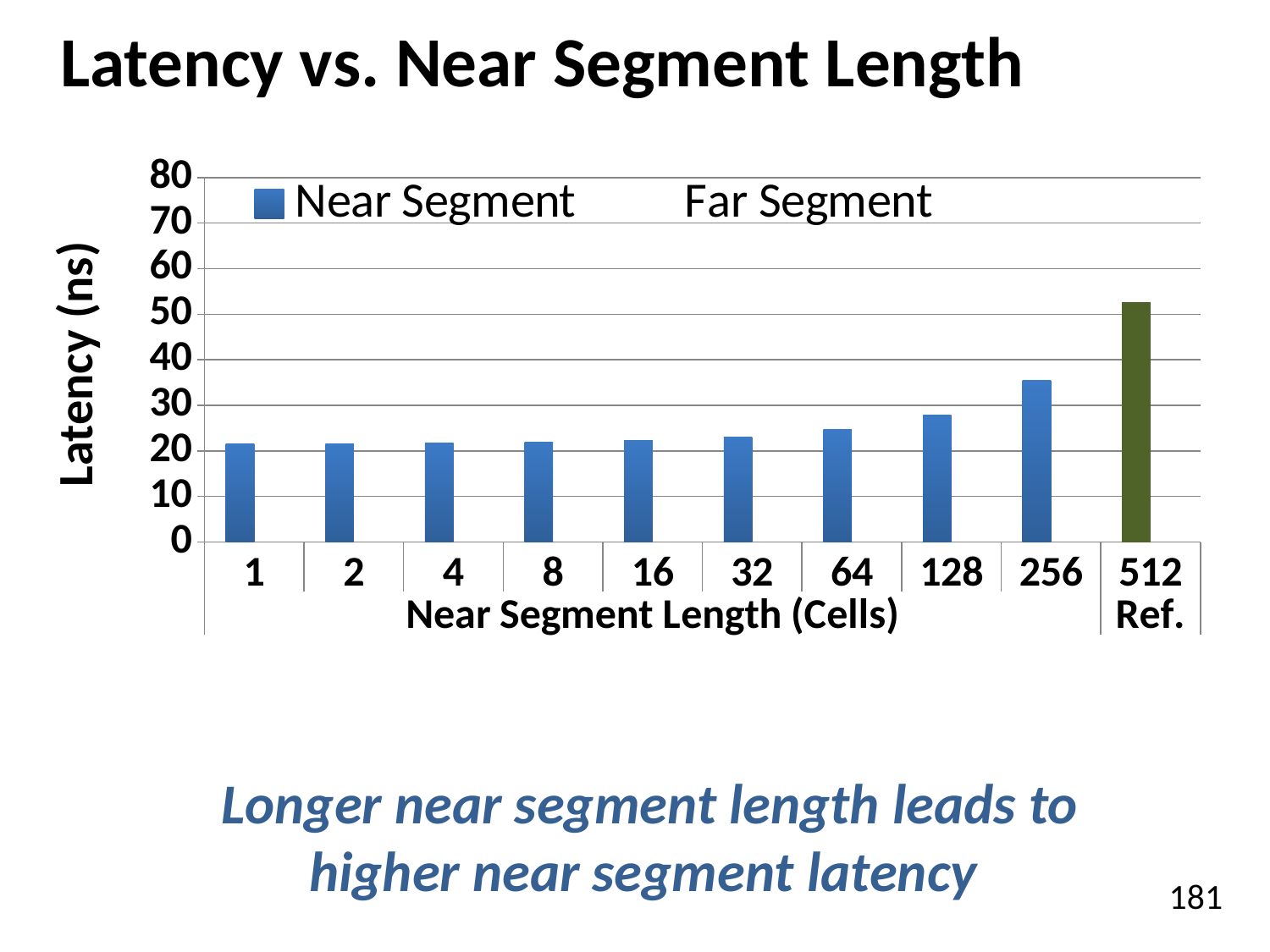
Is the latency for a near segment length of 1 greater or less than 20? greater What is the title of the chart on the slide? Latency vs. Near Segment Length What is the title of the y axis? Latency (ns) Do the near segment latency values rise or fall as near segment length increases along the x axis? rise How many bars are plotted in the chart? 10 Which has the higher latency, near segment length 256 or 128? 256 Which category has the highest latency? 512 Ref. How many series does the legend list? 2 Is the latency for 512 Ref. greater or less than 50? greater Is the latency for a near segment length of 128 greater or less than 30? less What kind of chart is shown on the slide? bar chart